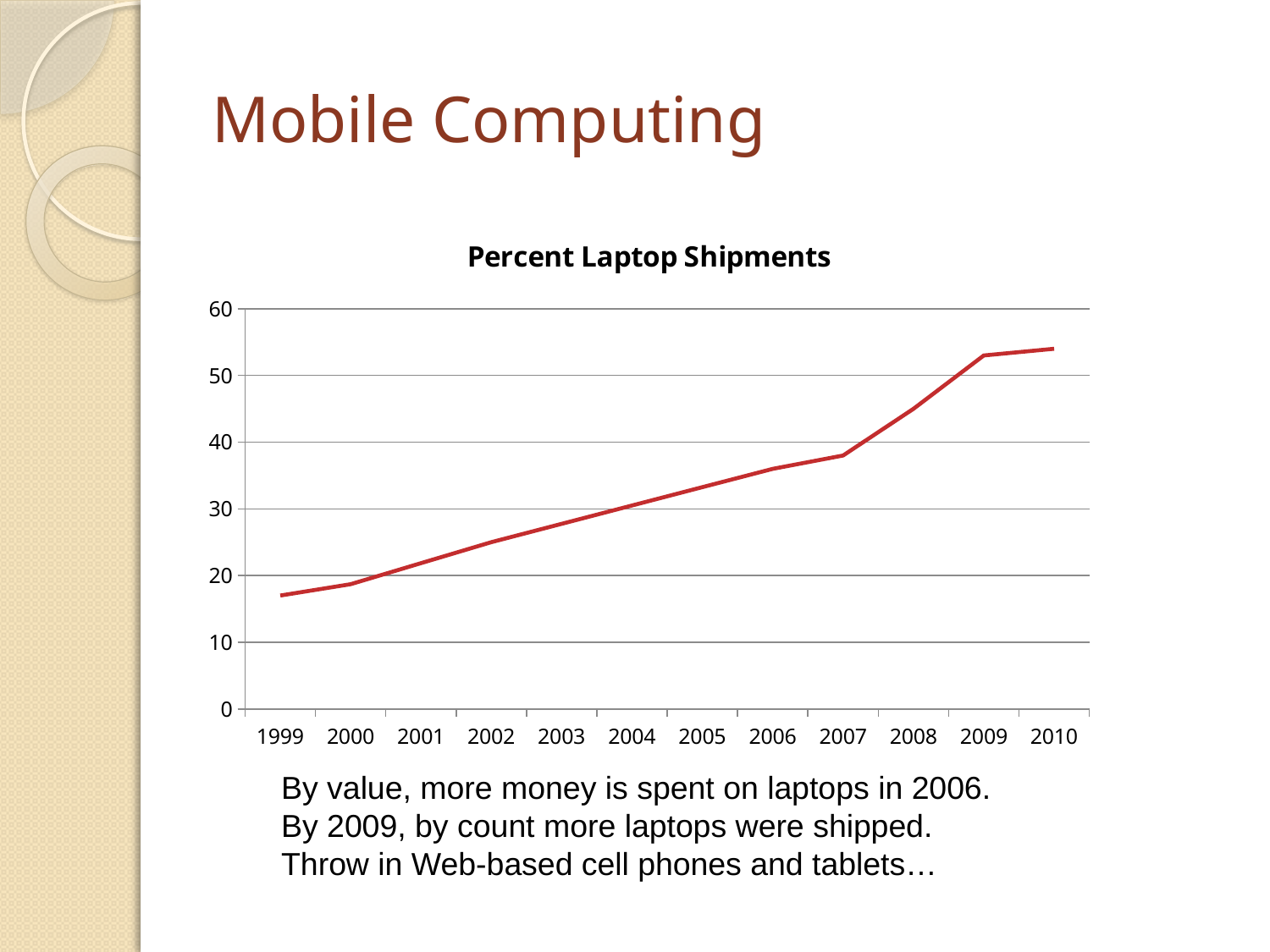
What is the title of the chart? Percent Laptop Shipments Is the value for 2007 greater or less than 40? less What is the first year shown on the x axis of the chart? 1999 Which year has the larger value, 2005 or 2009? 2009 Do the values in the chart rise or fall from 1999 to 2010? rise What kind of chart is shown on the slide? line chart Is the value for 2010 greater or less than 60? less Is the value for 2004 greater or less than 20? greater How many years are plotted along the x axis of the chart? 12 Which year has the lowest value in the chart? 1999